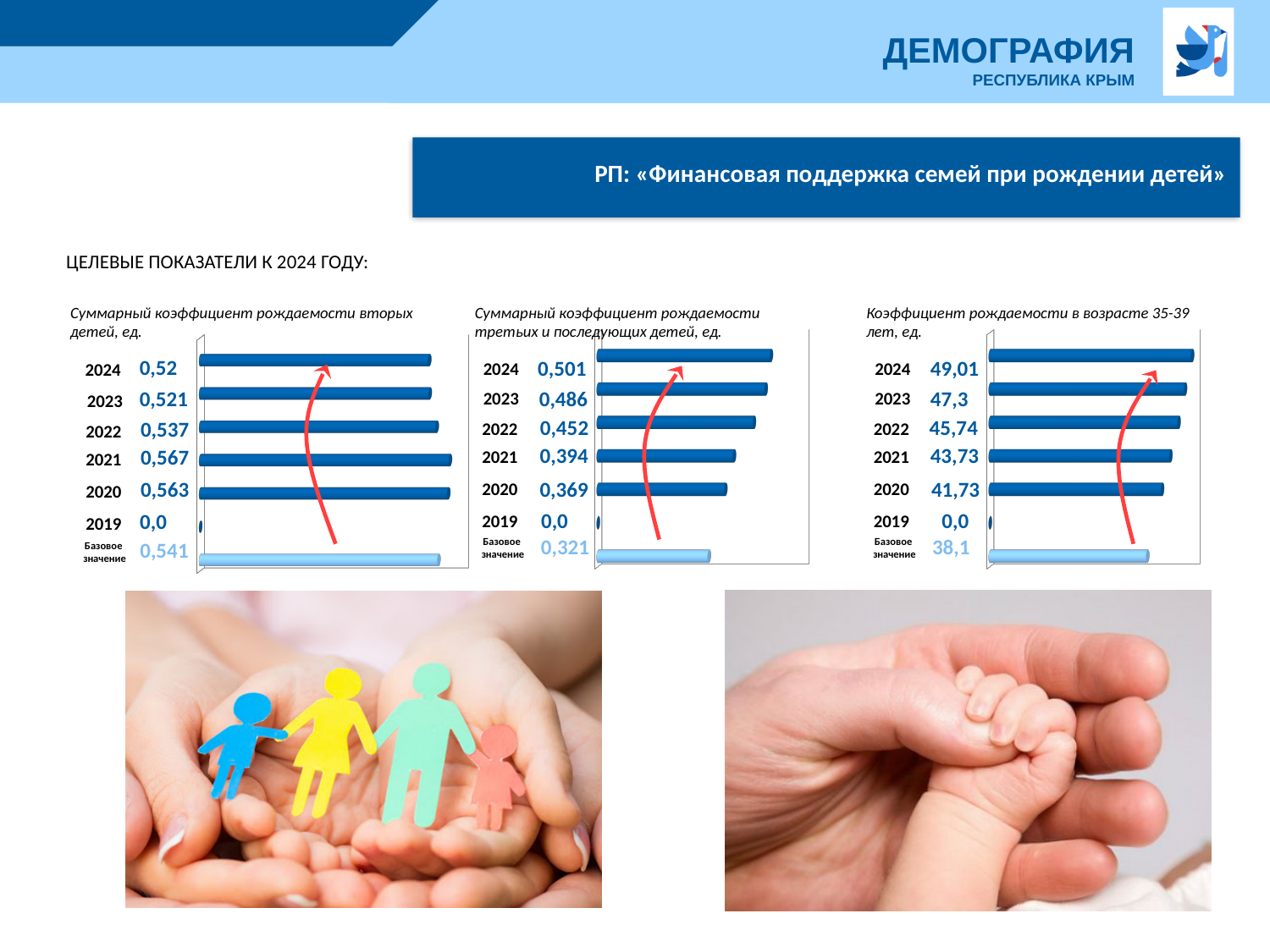
In the chart 'Суммарный коэффициент рождаемости третьих и последующих детей, ед.', what is the difference between the values for 2024 and 2020? 0,132 In the chart 'Коэффициент рождаемости в возрасте 35-39 лет, ед.', what is the value for 2021? 43,73 In the chart 'Коэффициент рождаемости в возрасте 35-39 лет, ед.', do the values rise or fall from 2020 to 2024? Rise In the chart 'Суммарный коэффициент рождаемости вторых детей, ед.', which year has the highest value? 2021 How many categories are shown in the chart 'Коэффициент рождаемости в возрасте 35-39 лет, ед.'? 7 In the chart 'Коэффициент рождаемости в возрасте 35-39 лет, ед.', what is the 'Базовое значение'? 38,1 What kind of chart is 'Суммарный коэффициент рождаемости третьих и последующих детей, ед.'? Bar chart In the chart 'Суммарный коэффициент рождаемости вторых детей, ед.', what is the value for 2022? 0,537 In the chart 'Суммарный коэффициент рождаемости третьих и последующих детей, ед.', which category has the lowest value? 2019 In the chart 'Суммарный коэффициент рождаемости вторых детей, ед.', which is larger: the value for 2024 or the 'Базовое значение'? Базовое значение In the chart 'Коэффициент рождаемости в возрасте 35-39 лет, ед.', what is the difference between the values for 2024 and 2020? 7,28 In the chart 'Суммарный коэффициент рождаемости третьих и последующих детей, ед.', what is the value for 2024? 0,501